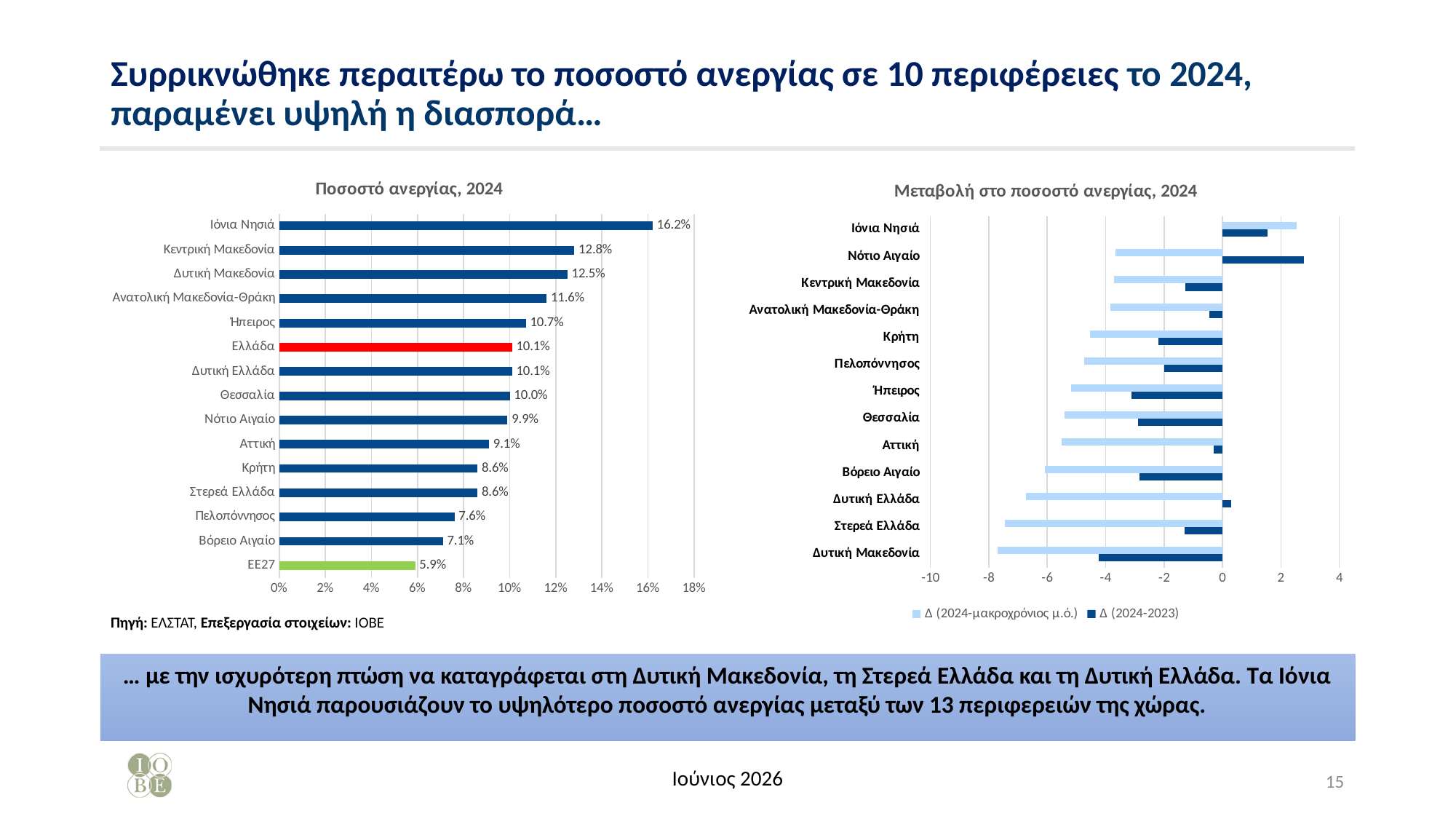
In the chart 'Ποσοστό ανεργίας, 2024', what is the difference between Ιόνια Νησιά and Κεντρική Μακεδονία? 3.4% In the chart 'Ποσοστό ανεργίας, 2024', which is larger, Ήπειρος or Αττική? Ήπειρος What type of chart is 'Μεταβολή στο ποσοστό ανεργίας, 2024'? Bar chart In the chart 'Ποσοστό ανεργίας, 2024', which category has the lowest value? ΕΕ27 In the chart 'Ποσοστό ανεργίας, 2024', which category has the highest value? Ιόνια Νησιά How many series does the legend of the chart 'Μεταβολή στο ποσοστό ανεργίας, 2024' list? 2 In the chart 'Ποσοστό ανεργίας, 2024', which bar is coloured red? Ελλάδα In the chart 'Ποσοστό ανεργίας, 2024', what is the value for Ιόνια Νησιά? 16.2% In the chart 'Ποσοστό ανεργίας, 2024', what is the value for ΕΕ27? 5.9% In the chart 'Μεταβολή στο ποσοστό ανεργίας, 2024', is the value of Δ (2024-μακροχρόνιος μ.ό.) for Δυτική Μακεδονία greater or less than -6? less How many categories are shown in the chart 'Ποσοστό ανεργίας, 2024'? 15 In the chart 'Ποσοστό ανεργίας, 2024', what is the value for Ελλάδα? 10.1%